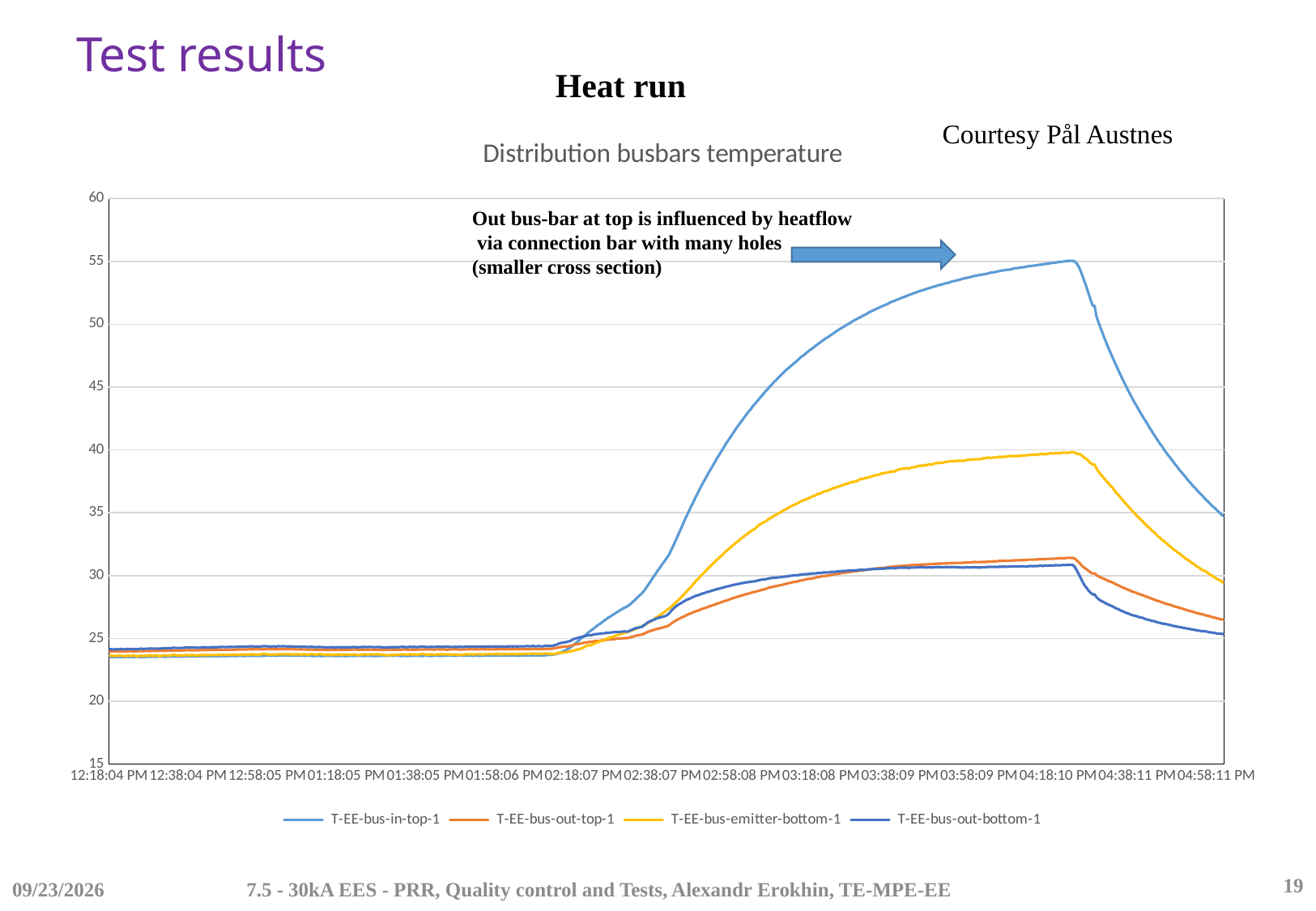
Which series reaches the highest peak temperature in the chart? T-EE-bus-in-top-1 What is the title of the chart? Distribution busbars temperature How many time labels are shown on the x axis of the chart? 15 Is the peak value of T-EE-bus-out-top-1 greater or less than 35? less Which series has the higher peak, T-EE-bus-emitter-bottom-1 or T-EE-bus-out-top-1? T-EE-bus-emitter-bottom-1 Is the peak value of T-EE-bus-in-top-1 greater or less than 50? greater What kind of chart is shown on the slide? line chart How do the temperatures change along the x axis between 02:18:07 PM and 04:18:10 PM? they rise Is the peak value of T-EE-bus-emitter-bottom-1 greater or less than 35? greater How many series does the legend of the chart list? 4 Which series is drawn in yellow in the chart? T-EE-bus-emitter-bottom-1